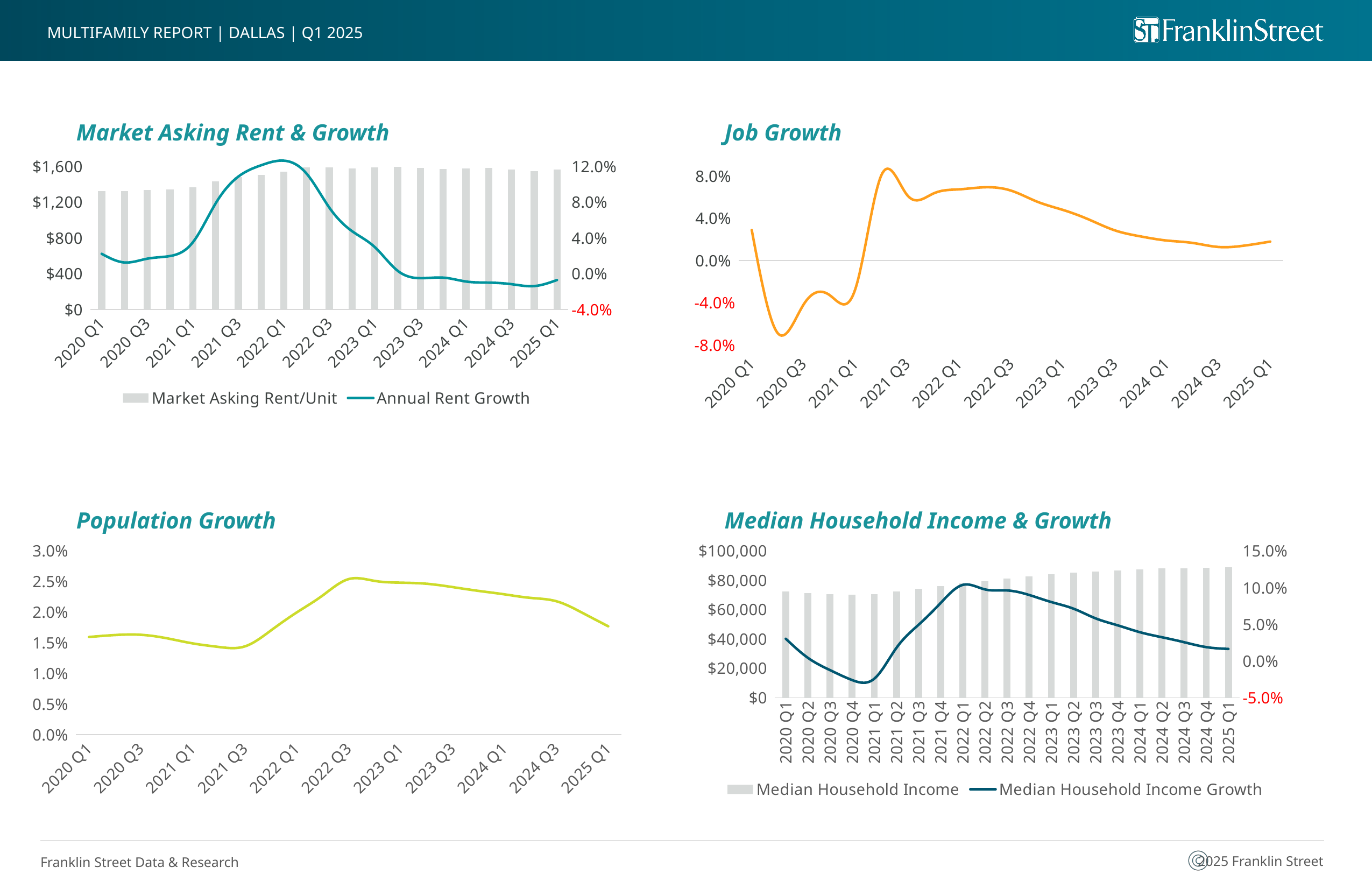
In the Market Asking Rent & Growth chart, is Annual Rent Growth in 2022 Q1 greater or less than 8.0%? greater In the Market Asking Rent & Growth chart, does Annual Rent Growth rise or fall from 2022 Q3 to 2025 Q1? fall In the Population Growth chart, around which quarter is population growth highest? 2022 Q3 What kind of chart is the Job Growth chart? line chart How many quarters are labelled on the x axis of the Median Household Income & Growth chart? 21 In the Market Asking Rent & Growth chart, is the Market Asking Rent/Unit for 2020 Q1 greater or less than $1,200? greater In the Median Household Income & Growth chart, is Median Household Income for 2025 Q1 greater or less than $80,000? greater In the Market Asking Rent & Growth chart, which series is drawn as bars? Market Asking Rent/Unit How many series does the legend of the Median Household Income & Growth chart list? 2 How many series does the legend of the Market Asking Rent & Growth chart list? 2